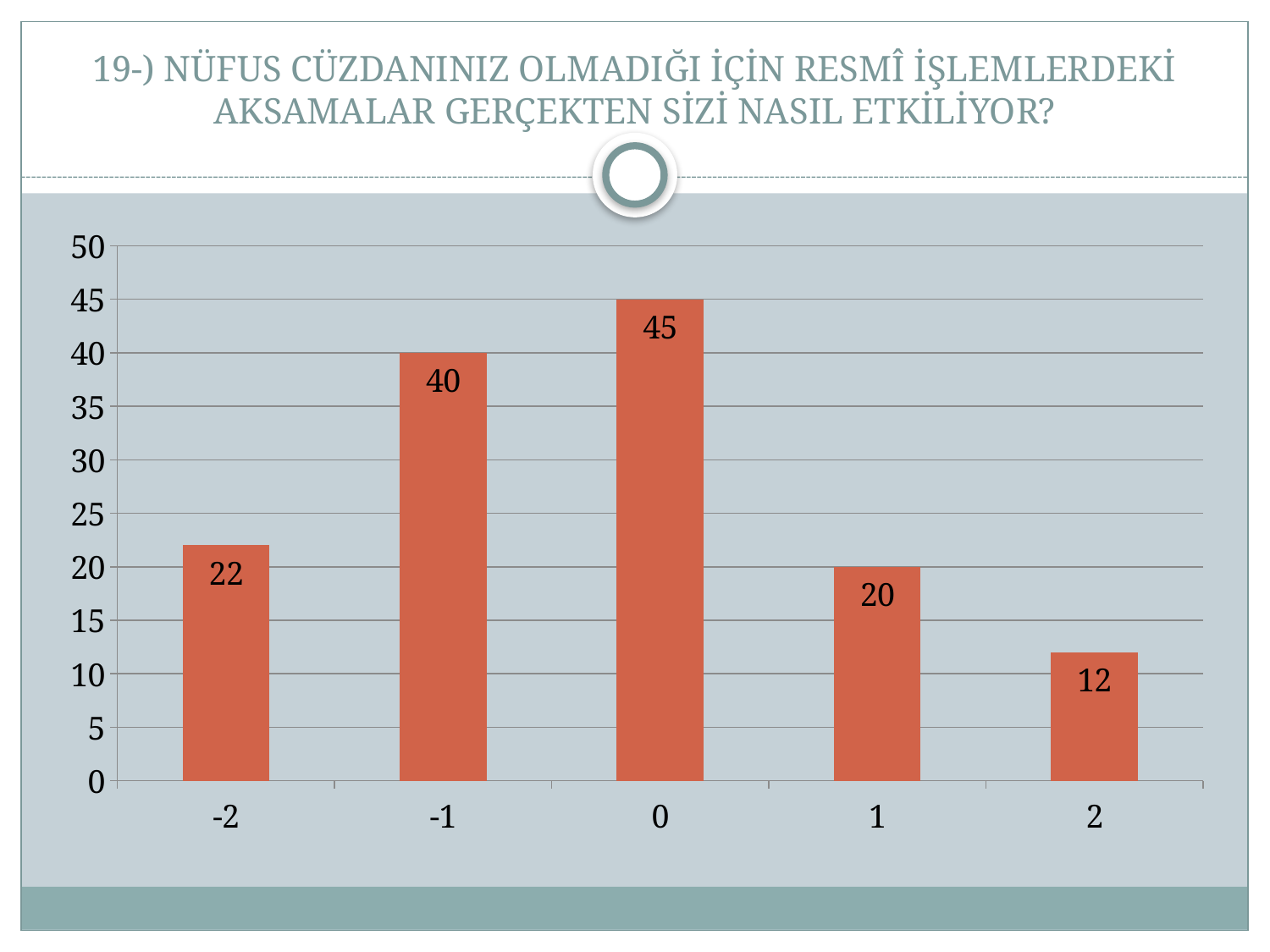
Which category has the lowest value? 2 What is the value for category -2? 22 Which category has the highest value? 0 What is the difference between the values for -2 and 2? 10 What kind of chart is shown on the slide? bar chart What is the value for category 0? 45 What is the difference between the values for 0 and -1? 5 Is the value for -1 greater or less than 35? greater What is the highest value shown on the y axis? 50 How many categories are shown on the x axis? 5 What is the value for category 2? 12 Which is larger, the value for -2 or the value for 1? -2